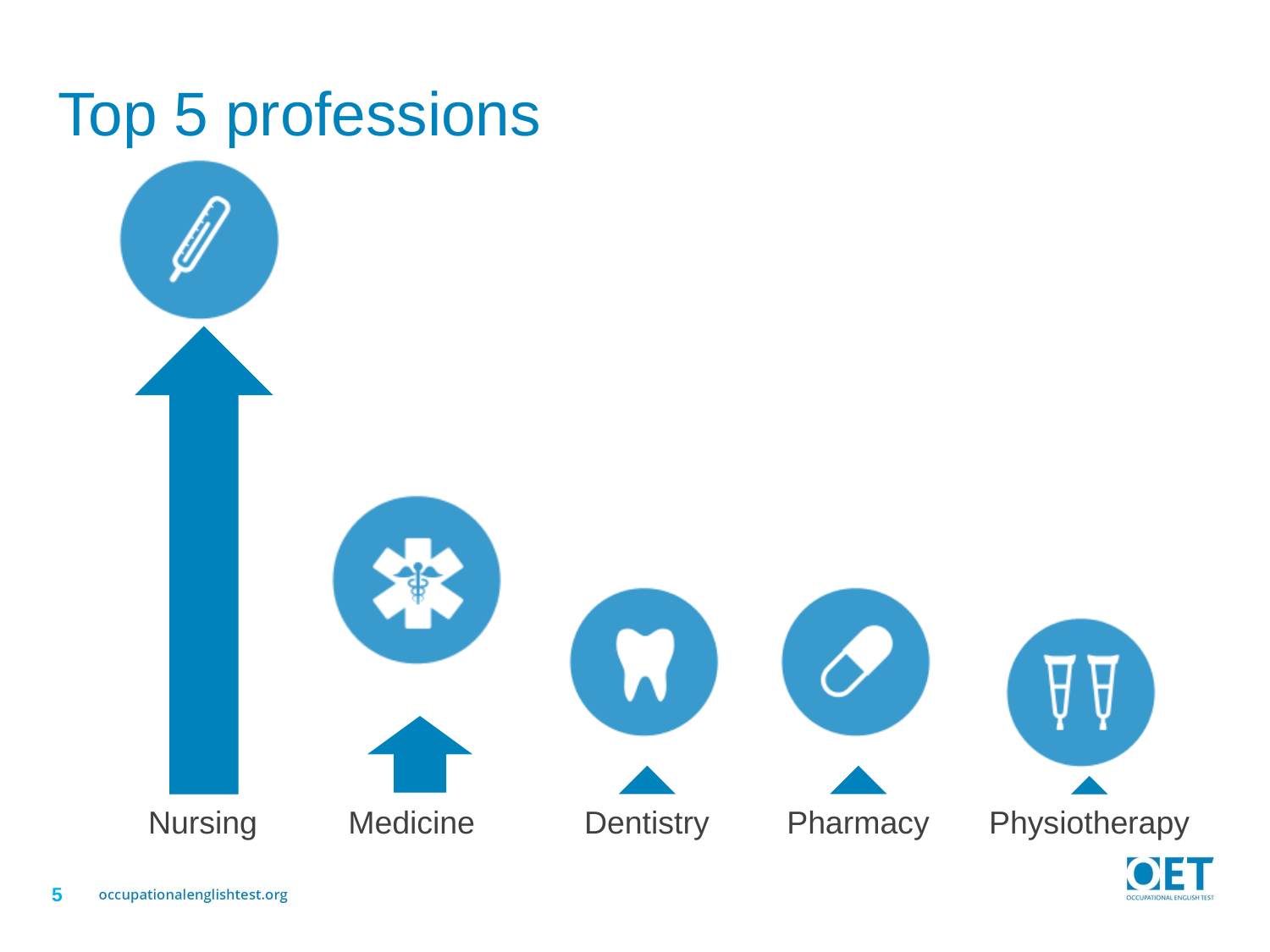
What icon is shown in the circle above the Dentistry arrow? A tooth Which has the taller arrow, Medicine or Physiotherapy? Medicine Which profession is listed second from the left on the chart? Medicine Do the arrow heights rise or fall from left to right across the professions? fall Which profession is listed furthest to the right on the chart? Physiotherapy How many professions are shown on the chart? 5 What is the title of the slide? Top 5 professions Which profession has the tallest arrow on the chart? Nursing Which profession has the smallest arrow on the chart? Physiotherapy Which has the taller arrow, Nursing or Medicine? Nursing Which has the taller arrow, Medicine or Dentistry? Medicine